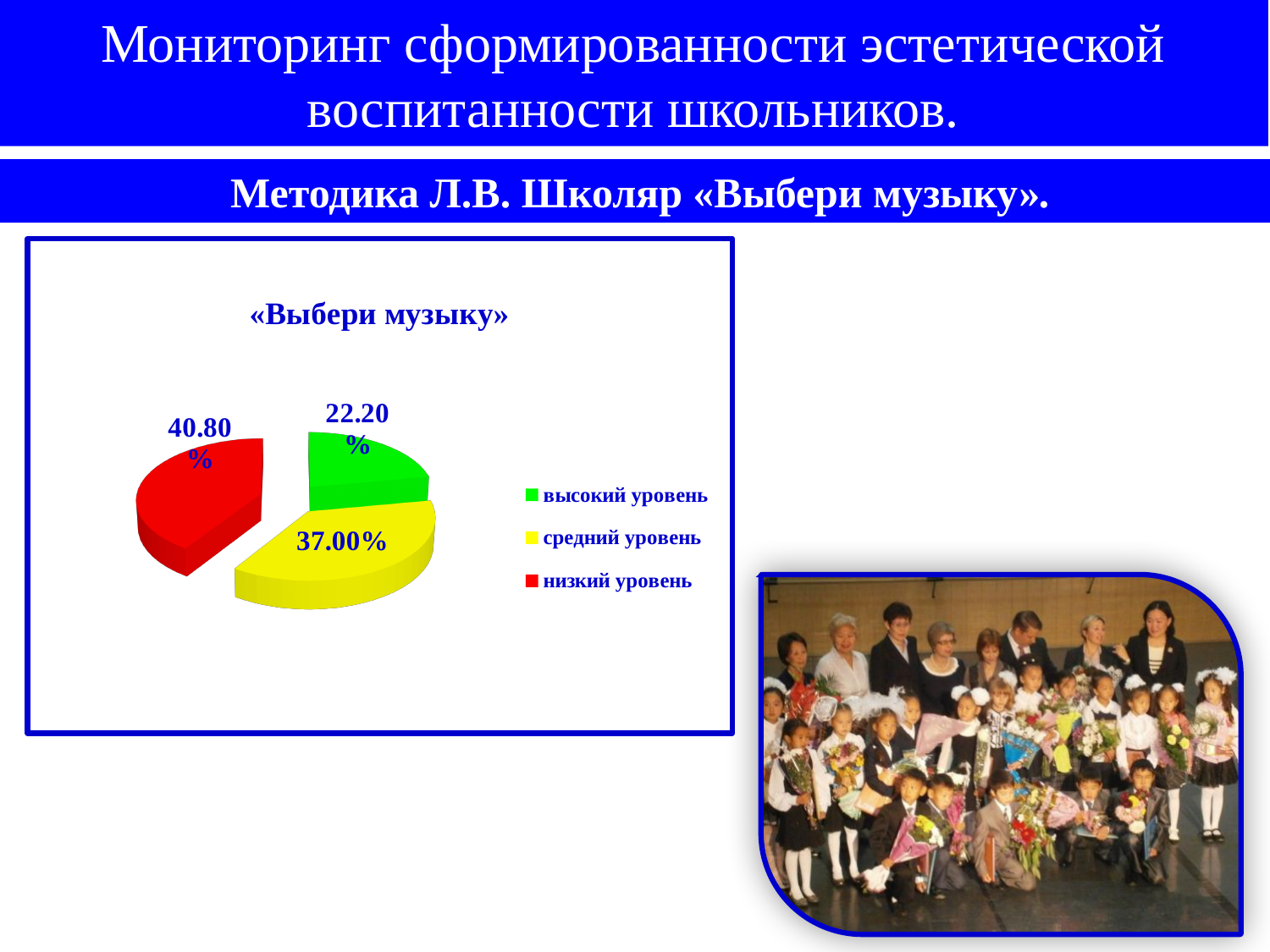
How many slices does the pie chart have? 3 Which is larger, the share for средний уровень or the share for высокий уровень? средний уровень What is the title of the chart? «Выбери музыку» What is the difference between the shares for низкий уровень and средний уровень? 3.80% What percentage is shown for высокий уровень? 22.20% What is the difference between the shares for низкий уровень and высокий уровень? 18.60% What percentage is shown for низкий уровень? 40.80% What kind of chart is shown on the slide? pie chart Which level has the smallest share of the pie? высокий уровень What colour is the slice for низкий уровень? red Which level has the largest share of the pie? низкий уровень What percentage is shown for средний уровень? 37.00%